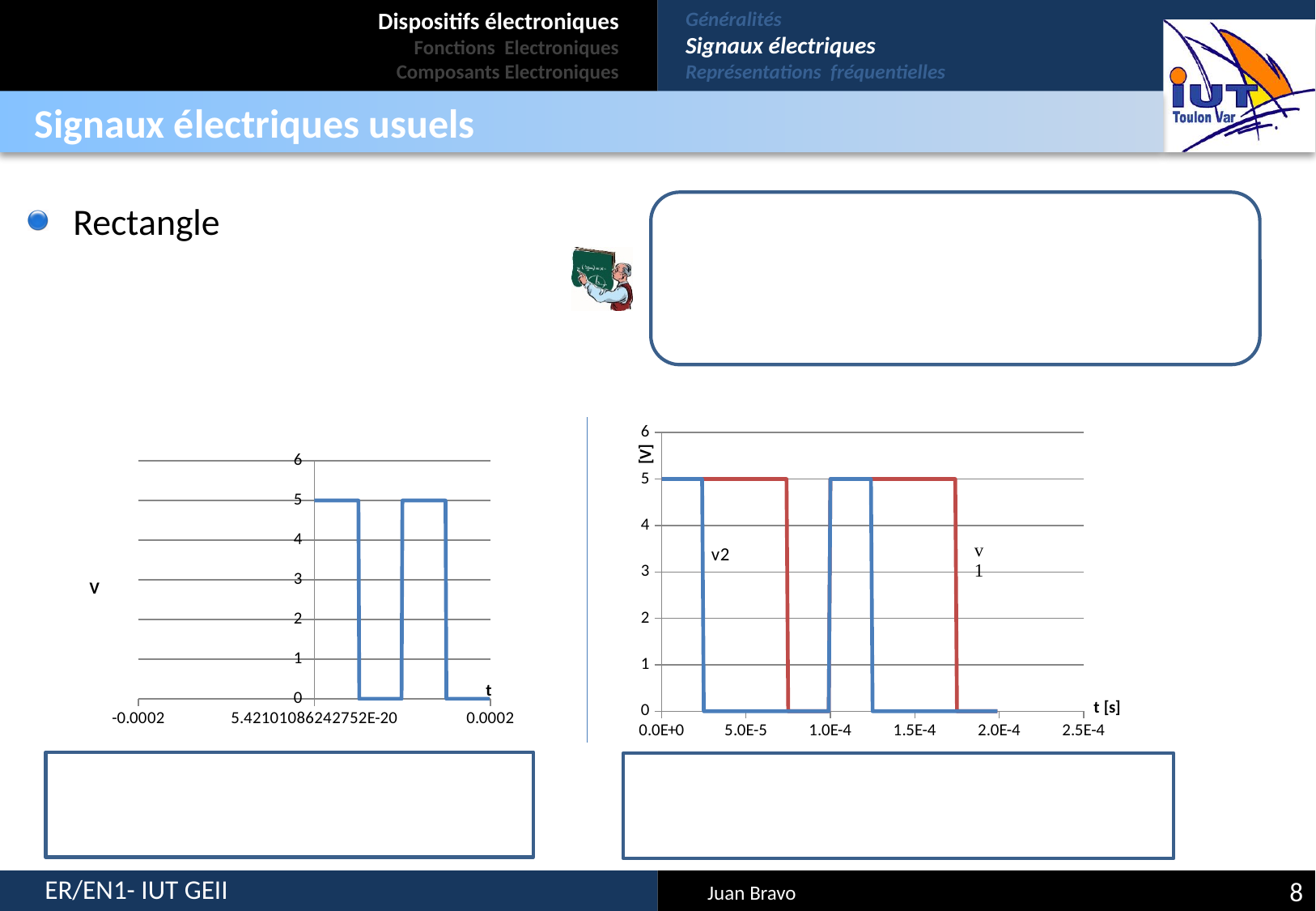
On the right chart, at t = 5.0E-5, which series has the larger value, v1 or v2? v1 On the right chart, which series is drawn in red? v1 On the left chart, what is the highest value the signal reaches? 5 On the right chart, what is the high level of the v1 signal? 5 On the right chart, how many signal series are plotted? 2 On the left chart, what is the lowest value the signal reaches? 0 On the left chart, what is the label of the vertical axis? v On the right chart, what is the value of v2 at t = 0.0E+0? 5 What kind of chart is the left chart on the slide? line chart On the right chart, is the high level of v2 greater or less than 4? greater On the right chart, what is the largest tick value shown on the horizontal axis? 2.5E-4 On the right chart, what is the value of v1 at t = 2.0E-4? 0